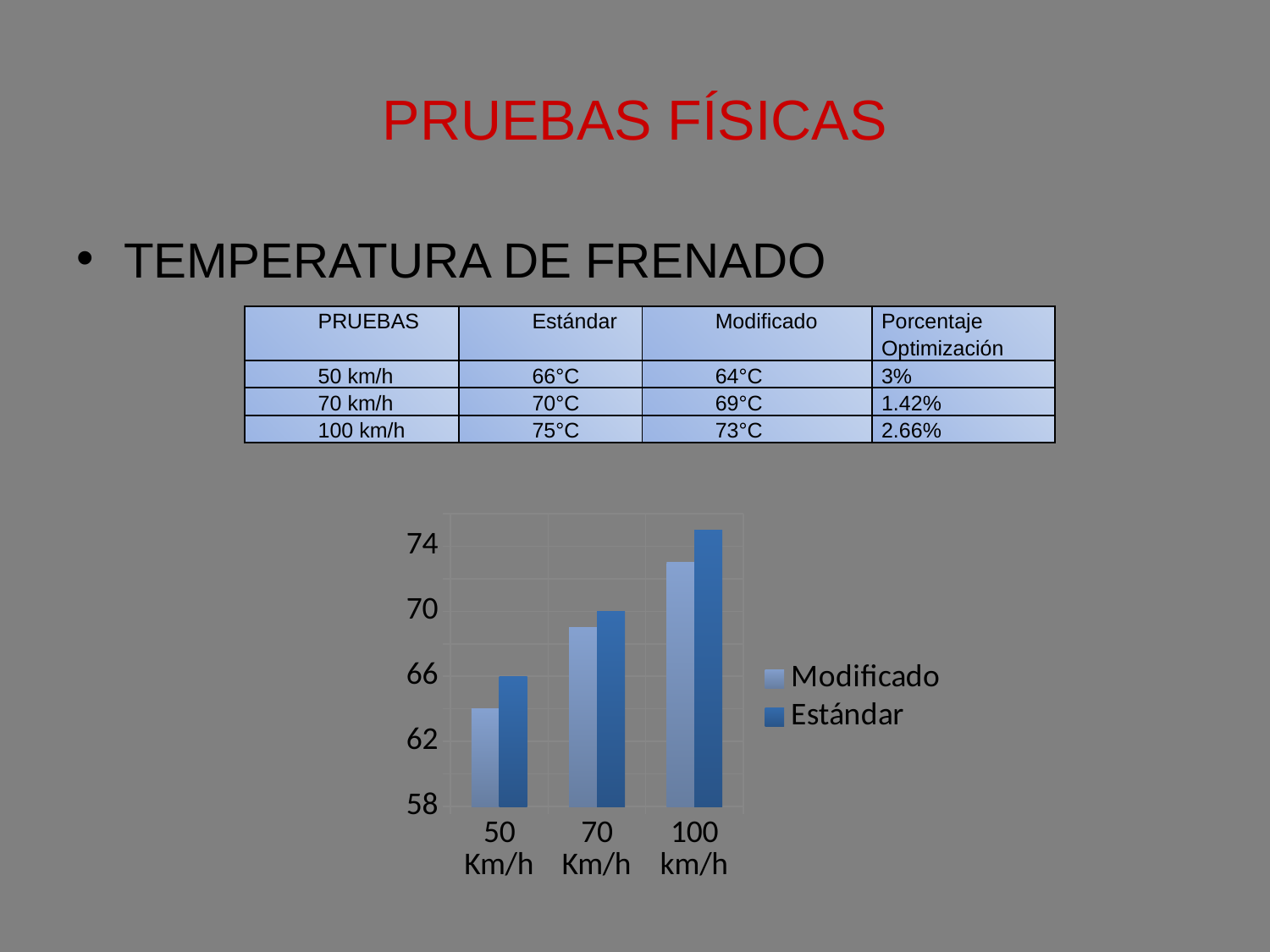
At which speed is the Estándar bar highest? 100 km/h How many speed categories are shown on the x axis of the chart? 3 Is the Modificado value at 50 Km/h greater or less than 66? less What is the Estándar value at 50 Km/h in the chart? 66°C What is the Modificado value at 100 km/h in the chart? 73°C How many series does the chart legend list? 2 At which speed is the Modificado bar lowest? 50 Km/h At 70 Km/h, which series has the larger value, Estándar or Modificado? Estándar What is the difference between the Estándar and Modificado values at 100 km/h? 2°C Do the Estándar values rise or fall as speed increases along the x axis? rise What kind of chart is shown on the slide? bar chart What are the two entries in the chart legend? Modificado and Estándar